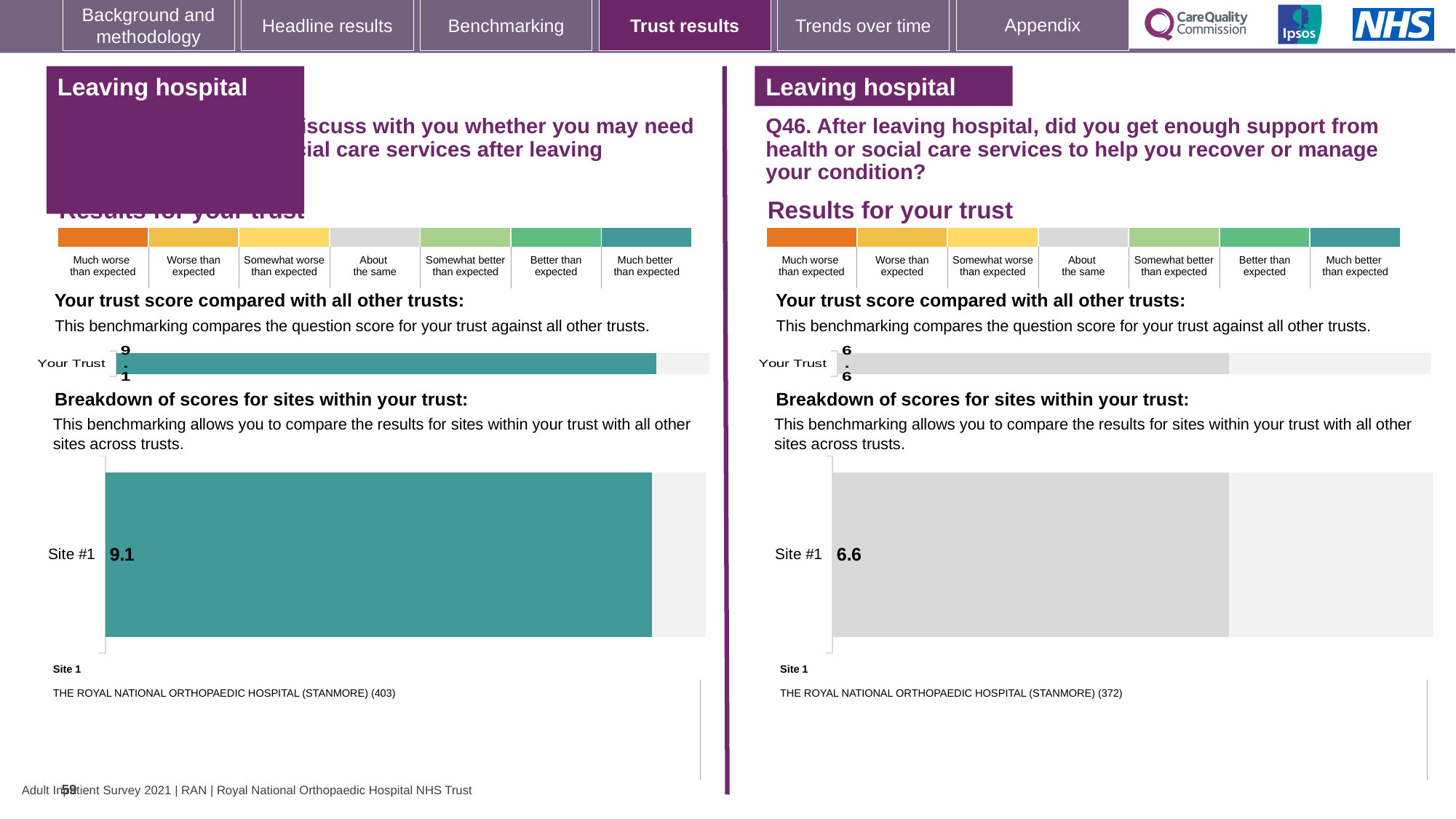
Which site is listed as Site 1 beneath the left-hand site breakdown chart? THE ROYAL NATIONAL ORTHOPAEDIC HOSPITAL (STANMORE) (403) Which is larger: the 'Your Trust' score in the left-hand chart or the 'Your Trust' score in the right-hand (Q46) chart? The left-hand chart (9.1) How many sites are shown in the right-hand (Q46) 'Breakdown of scores for sites within your trust' chart? 1 In the left-hand 'Breakdown of scores for sites within your trust' chart, what is the score for Site #1? 9.1 How many sites are shown in the left-hand 'Breakdown of scores for sites within your trust' chart? 1 What type of chart is used to show the Site #1 score on the right half of the slide? Bar chart What is the difference between the Site #1 score in the left-hand site breakdown chart and the Site #1 score in the right-hand (Q46) site breakdown chart? 2.5 What type of chart is used to show the 'Your Trust' score on the left half of the slide? Bar chart Which site is listed as Site 1 beneath the right-hand (Q46) site breakdown chart? THE ROYAL NATIONAL ORTHOPAEDIC HOSPITAL (STANMORE) (372) On the left half of the slide, what is the 'Your Trust' score shown in the trust benchmarking bar chart? 9.1 In the right-hand (Q46) 'Breakdown of scores for sites within your trust' chart, what is the score for Site #1? 6.6 On the right half of the slide (Q46), what is the 'Your Trust' score shown in the trust benchmarking bar chart? 6.6